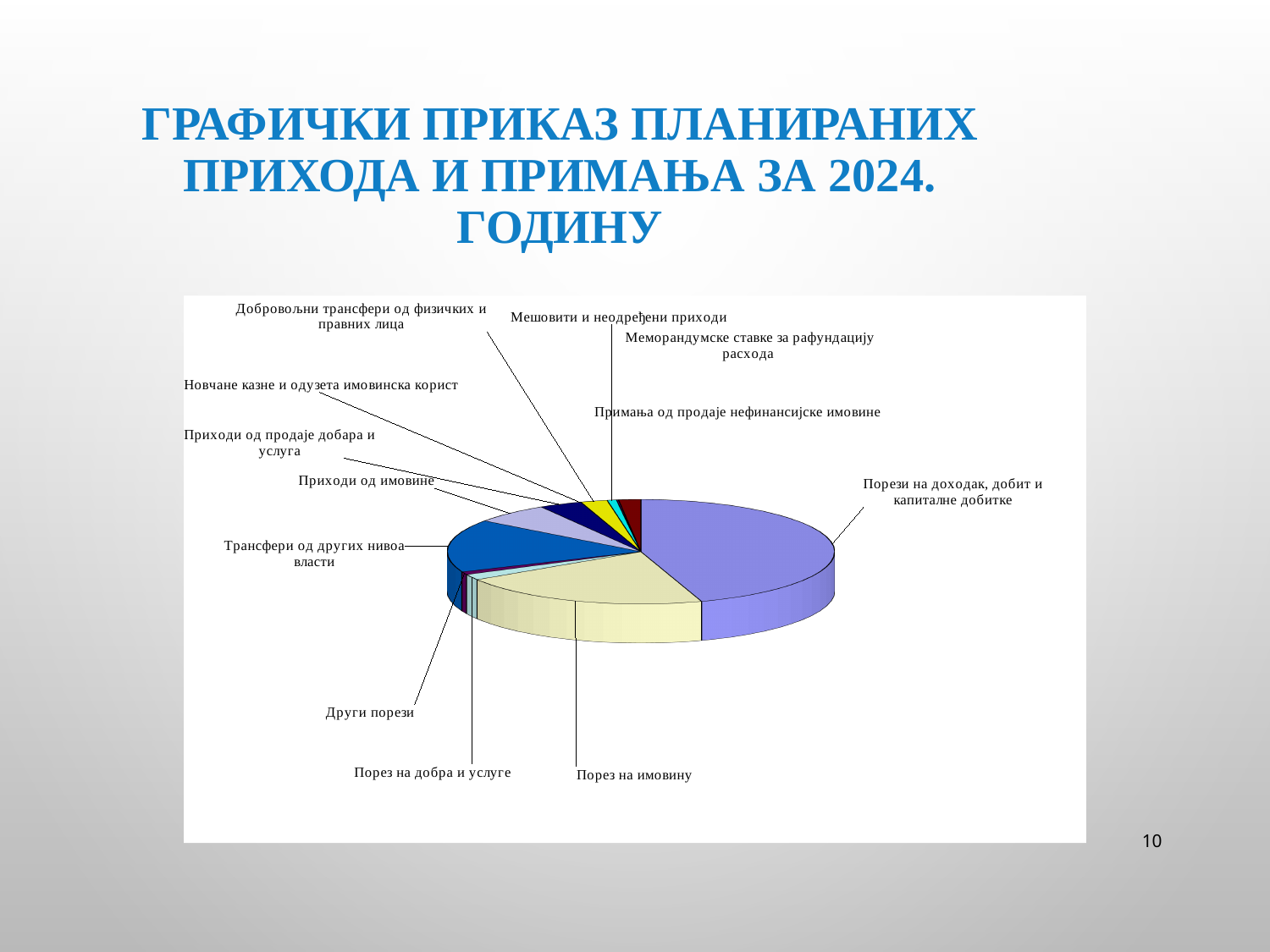
What is the title of the slide containing the pie chart? ГРАФИЧКИ ПРИКАЗ ПЛАНИРАНИХ ПРИХОДА И ПРИМАЊА ЗА 2024. ГОДИНУ Which slice is larger: Трансфери од других нивоа власти or Приходи од имовине? Трансфери од других нивоа власти Which category is the second-largest slice of the pie chart? Порез на имовину Which slice is larger: Порез на добра и услуге or Порези на доходак, добит и капиталне добитке? Порези на доходак, добит и капиталне добитке What kind of chart is shown on the slide? Pie chart Which category has the largest slice of the pie chart? Порези на доходак, добит и капиталне добитке Which slice is larger: Порез на имовину or Други порези? Порез на имовину Does the pie chart display numeric data labels on its slices? No How many categories (slices) are labelled in the pie chart? 12